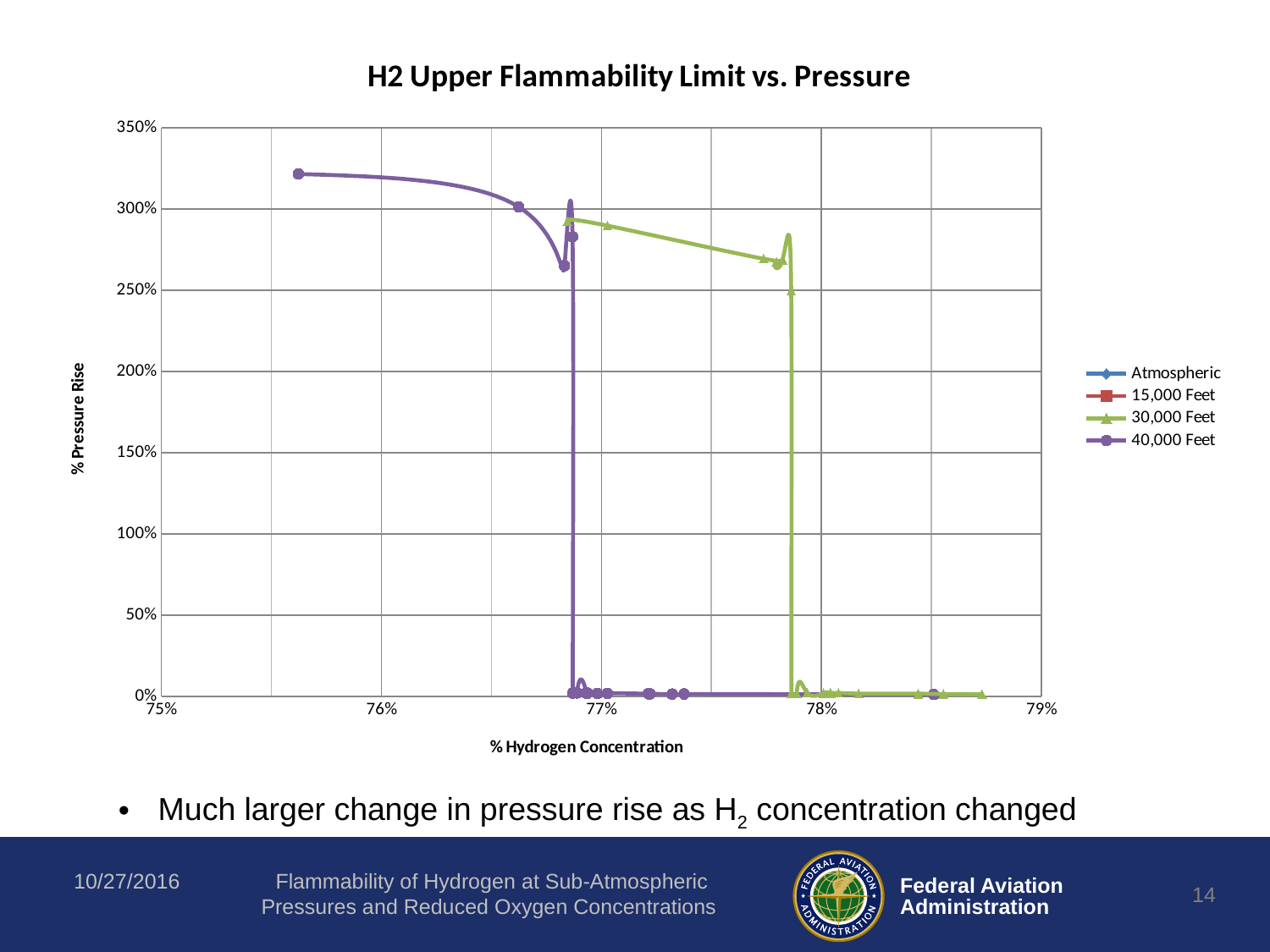
Is the highest plotted value of the 40,000 Feet series greater or less than 300%? greater What is the label on the vertical axis of the chart? % Pressure Rise Is the value of the 30,000 Feet series at about 77% hydrogen concentration greater or less than 250%? greater Before its sharp drop, does the pressure rise for the 30,000 Feet series rise or fall as hydrogen concentration increases? fall How many series does the legend list? 4 What kind of chart is shown on the slide? Line chart What is the title of the chart? H2 Upper Flammability Limit vs. Pressure Is the value of the 40,000 Feet series at about 77.2% hydrogen concentration greater or less than 50%? less Which series reaches the higher peak pressure rise, 30,000 Feet or 40,000 Feet? 40,000 Feet Before its sharp drop, does the pressure rise for the 40,000 Feet series rise or fall as hydrogen concentration increases? fall Which plotted series drops to near 0% pressure rise at the lower hydrogen concentration? 40,000 Feet